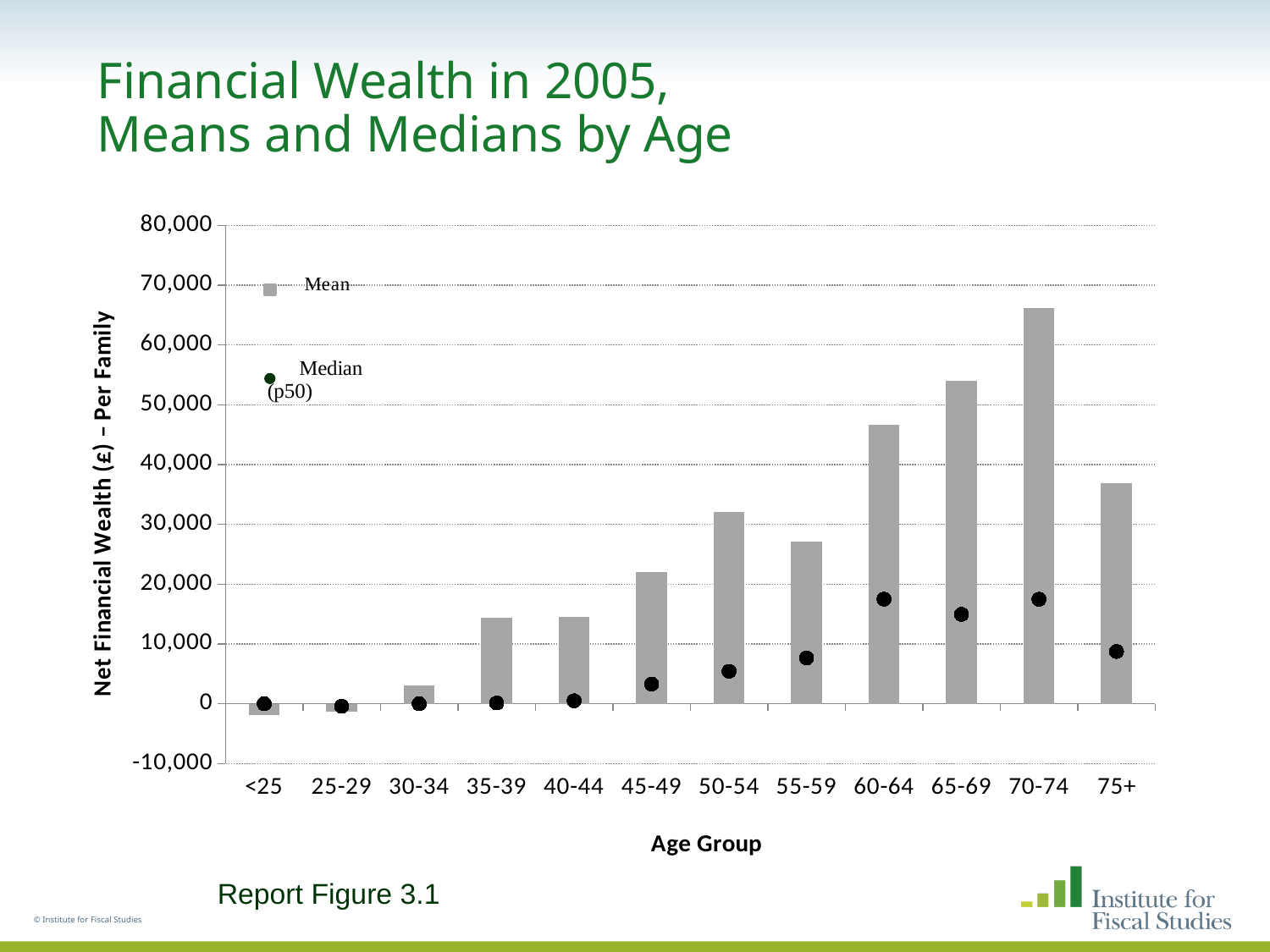
Do the mean values generally rise or fall from the <25 age group to the 70-74 age group? rise How many age groups are shown on the x axis? 12 Which has the larger median (p50) net financial wealth, the 65-69 or the 75+ age group? 65-69 What kind of chart is shown on the slide? Combination bar and line chart (bars for the mean, dots for the median) Which age group has the highest mean net financial wealth? 70-74 Is the mean value for the 55-59 age group greater or less than 30,000? less How many series does the legend list? 2 Which has the larger mean net financial wealth, the 50-54 or the 55-59 age group? 50-54 Is the median (p50) value for the 60-64 age group greater or less than 20,000? less Is the mean value for the 75+ age group greater or less than 40,000? less What is the title of the vertical axis? Net Financial Wealth (£) – Per Family